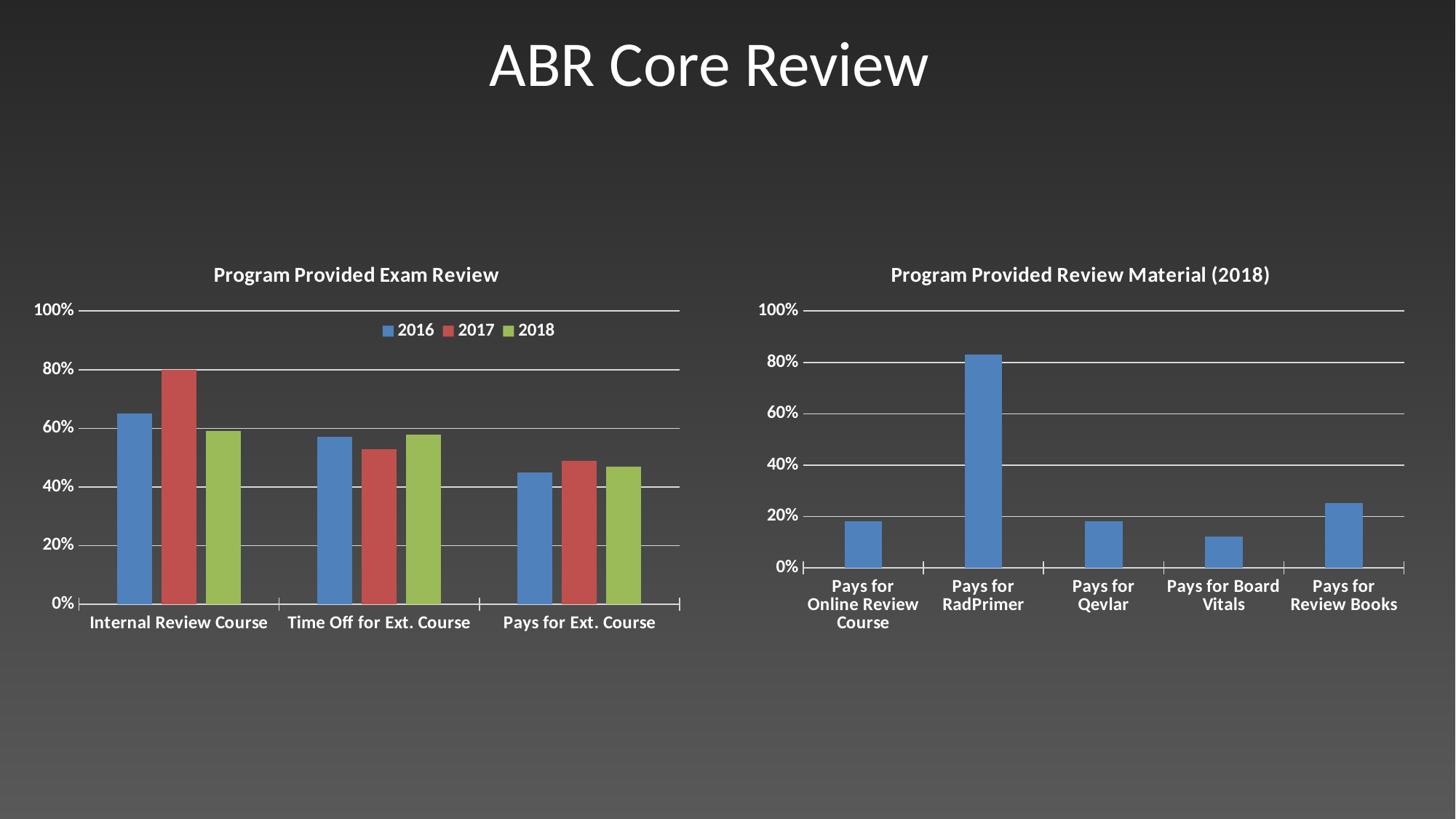
In the 'Program Provided Review Material (2018)' chart, how many categories are shown? 5 In the 'Program Provided Exam Review' chart, how many categories are shown on the x axis? 3 In the 'Program Provided Review Material (2018)' chart, which category has the lowest value? Pays for Board Vitals What is the title of the chart on the right side of the slide? Program Provided Review Material (2018) In the 'Program Provided Exam Review' chart, how many series does the legend list? 3 In the 'Program Provided Exam Review' chart, what kind of chart is shown? bar chart In the 'Program Provided Review Material (2018)' chart, is the value for Pays for RadPrimer greater or less than 80%? greater In the 'Program Provided Exam Review' chart, is the 2017 value for Internal Review Course greater or less than 60%? greater In the 'Program Provided Exam Review' chart, which year has the highest value for Internal Review Course? 2017 In the 'Program Provided Exam Review' chart, which is larger for 2016: Internal Review Course or Pays for Ext. Course? Internal Review Course In the 'Program Provided Exam Review' chart, is the 2016 value for Pays for Ext. Course greater or less than 60%? less In the 'Program Provided Review Material (2018)' chart, which category has the highest value? Pays for RadPrimer